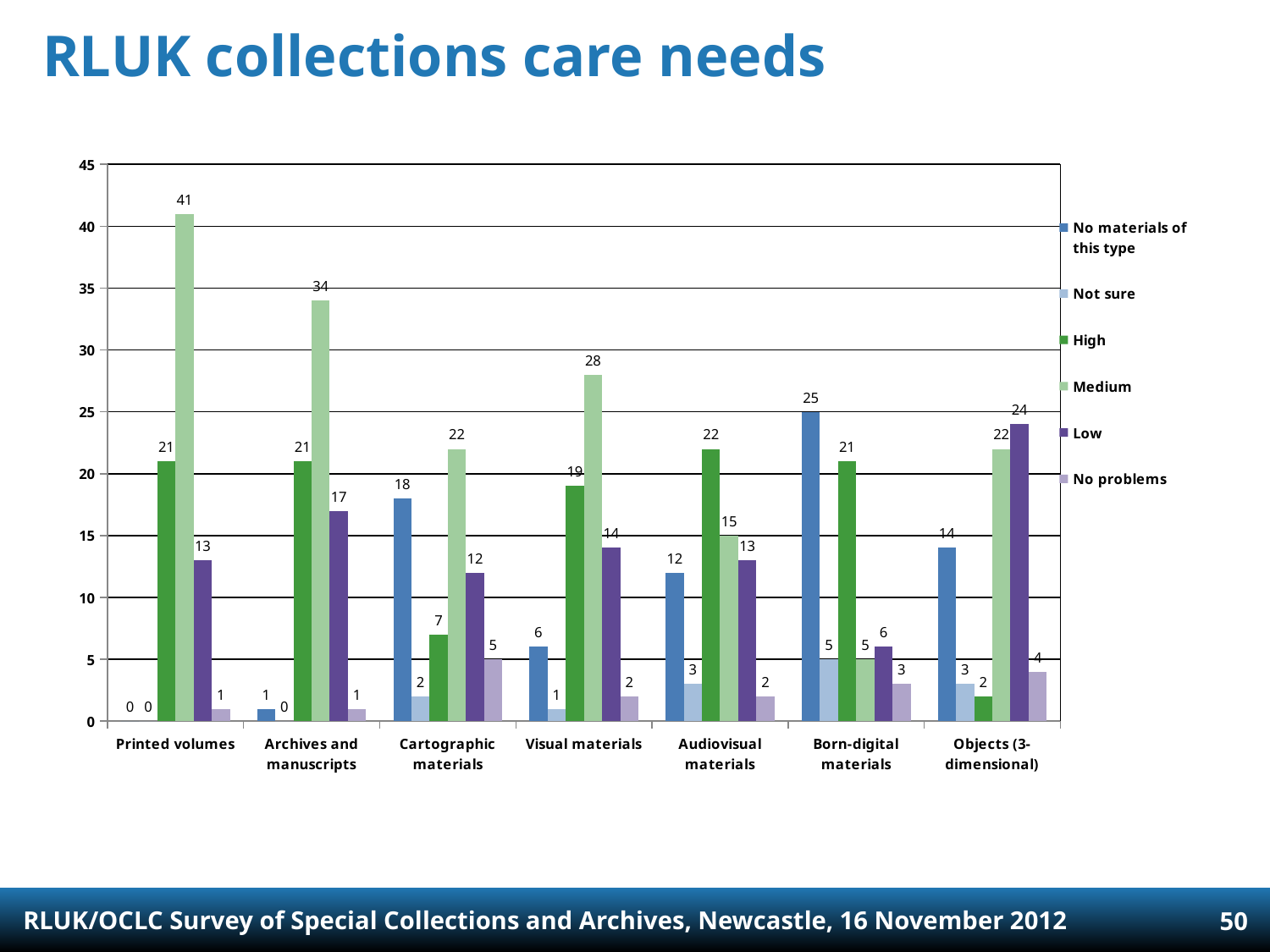
What is the title of the slide containing the chart? RLUK collections care needs What kind of chart is shown on the slide? Bar chart Which category has the highest Medium value? Printed volumes What is the Low value for Objects (3-dimensional)? 24 Which category has the lowest High value? Objects (3-dimensional) What is the difference between the Medium values for Printed volumes and Archives and manuscripts? 7 Which is larger for Cartographic materials: the No materials of this type value or the High value? No materials of this type What is the Medium value for Printed volumes? 41 What is the value for No materials of this type for Born-digital materials? 25 How many series does the legend list? 6 What is the High value for Audiovisual materials? 22 How many categories are shown on the x axis? 7